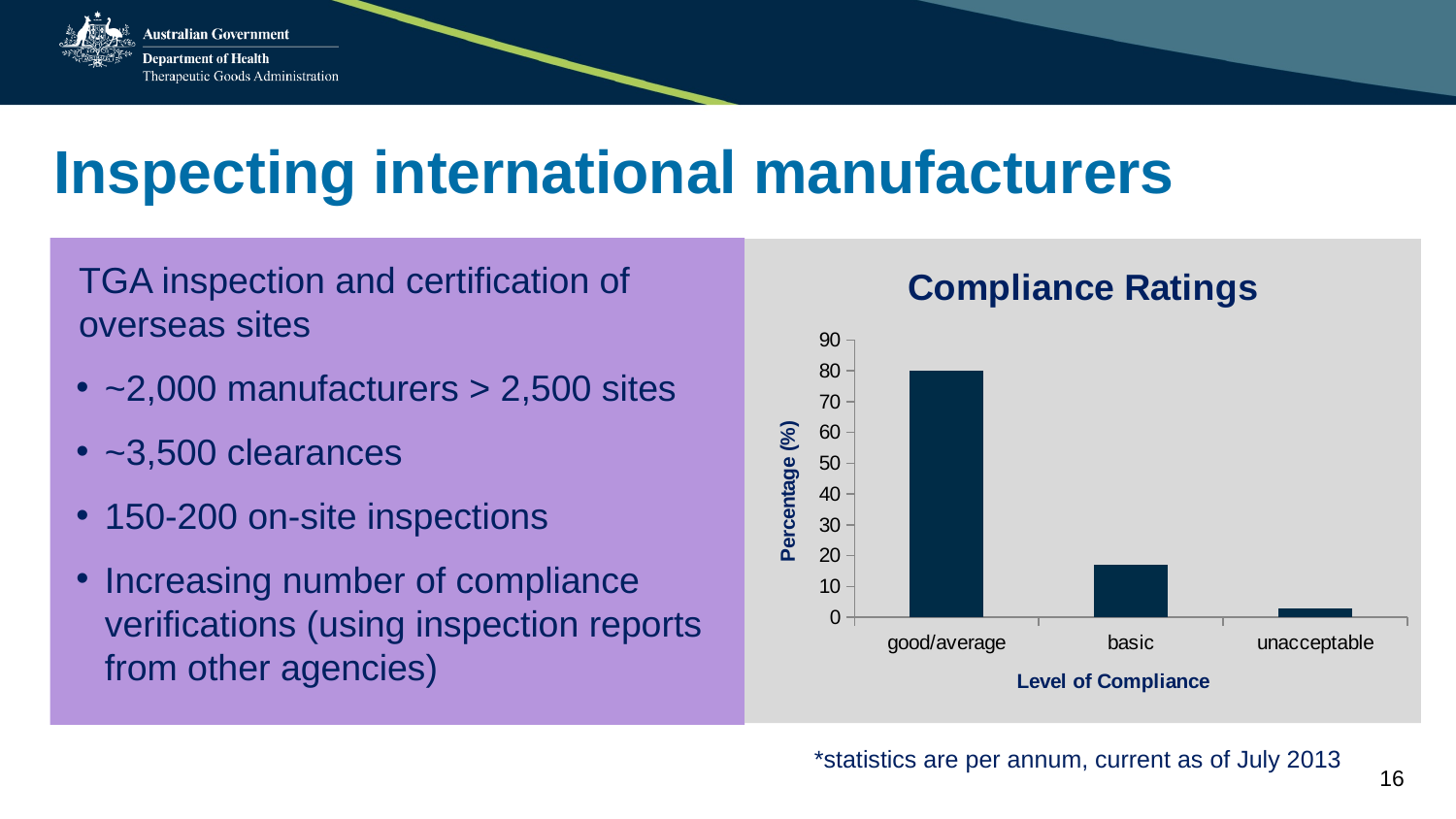
Which level of compliance has the lowest percentage in the Compliance Ratings chart? unacceptable Is the value for basic greater or less than 10? greater What is the label of the y axis of the chart? Percentage (%) Is the value for good/average greater or less than 70? greater Is the percentage for basic larger or smaller than the percentage for unacceptable? larger Is the value for basic greater or less than 20? less Do the values rise or fall moving from good/average to unacceptable along the x axis? fall What is the title of the chart? Compliance Ratings How many levels of compliance are shown on the x axis of the Compliance Ratings chart? 3 Which level of compliance has the highest percentage in the Compliance Ratings chart? good/average What kind of chart is shown on the slide? bar chart